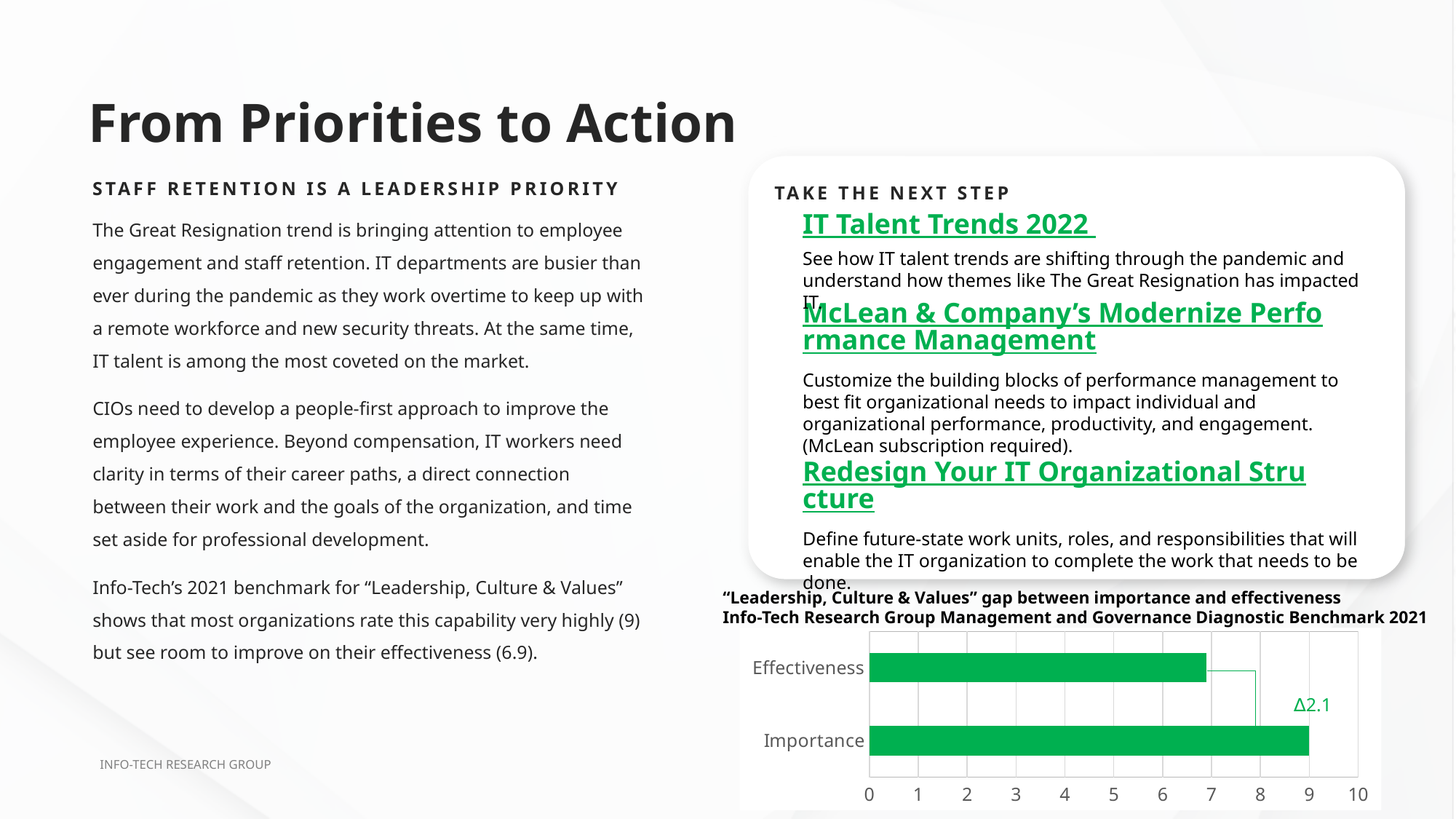
Is the value for Importance greater or less than 8? greater What is the value for Importance in the chart? 9 What gap (delta) between Importance and Effectiveness is labelled on the chart? 2.1 How many categories are plotted in the chart? 2 What is the highest value shown on the chart's horizontal axis? 10 What colour are the bars in the chart? green Which is larger, the value for Importance or the value for Effectiveness? Importance Is the value for Effectiveness greater or less than 6? greater Is the value for Effectiveness greater or less than 8? less Which category has the lowest value in the chart? Effectiveness What kind of chart is shown on the slide? bar chart Which category has the highest value in the chart? Importance